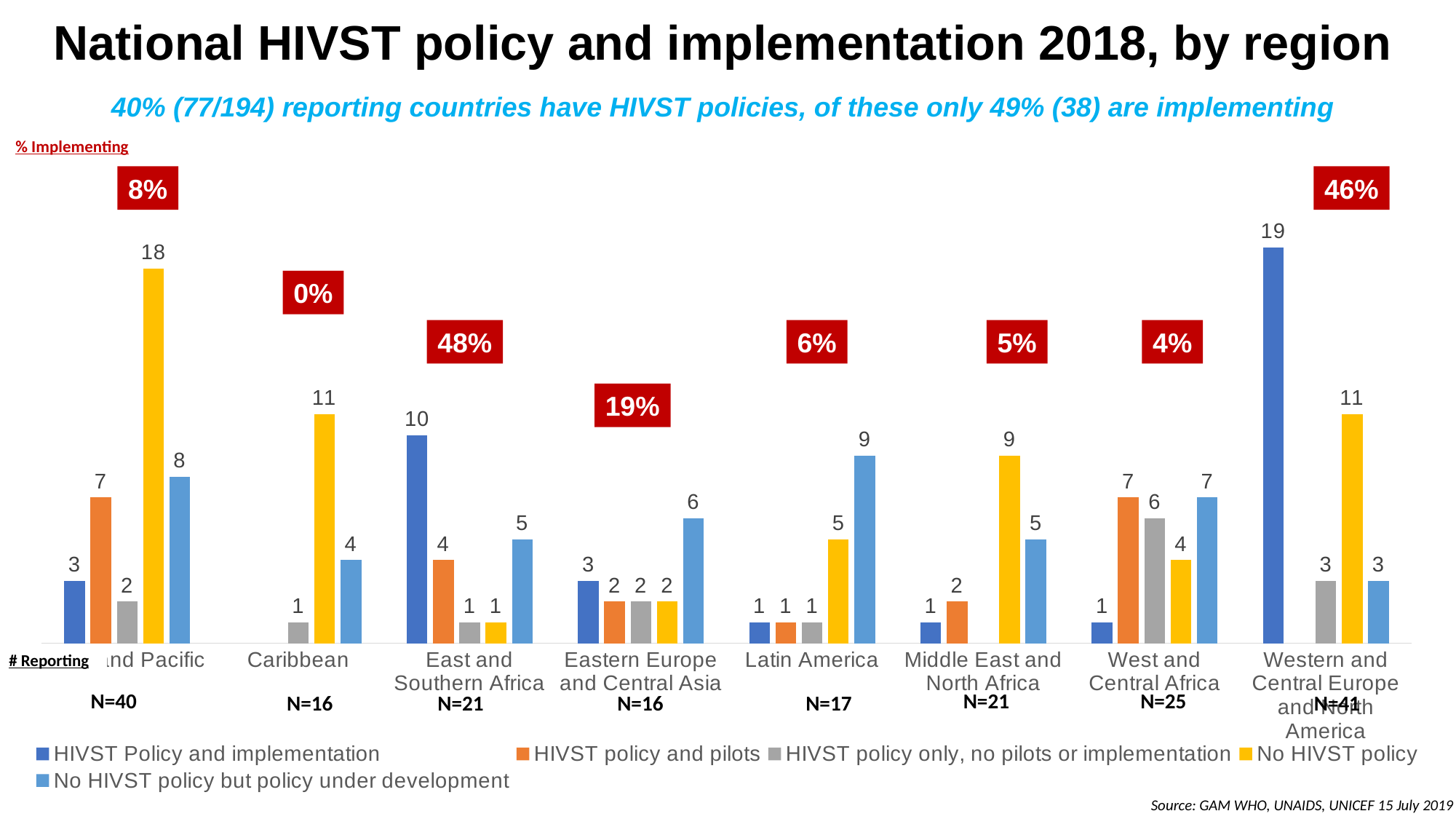
What is the value for No HIVST policy in the Caribbean? 11 What is the value for HIVST policy only, no pilots or implementation in West and Central Africa? 6 What kind of chart is shown on the slide? bar chart What % Implementing is shown for East and Southern Africa? 48% Which region has the highest value for HIVST Policy and implementation? Western and Central Europe and North America How many series does the legend list? 5 In East and Southern Africa, what is the difference between HIVST Policy and implementation and HIVST policy and pilots? 6 What is the value for No HIVST policy but policy under development in Latin America? 9 What is the value for HIVST Policy and implementation in Western and Central Europe and North America? 19 What is the number of reporting countries (N) shown for West and Central Africa? N=25 In Middle East and North Africa, which is larger: No HIVST policy or No HIVST policy but policy under development? No HIVST policy How many regions are shown on the x axis of the chart? 8